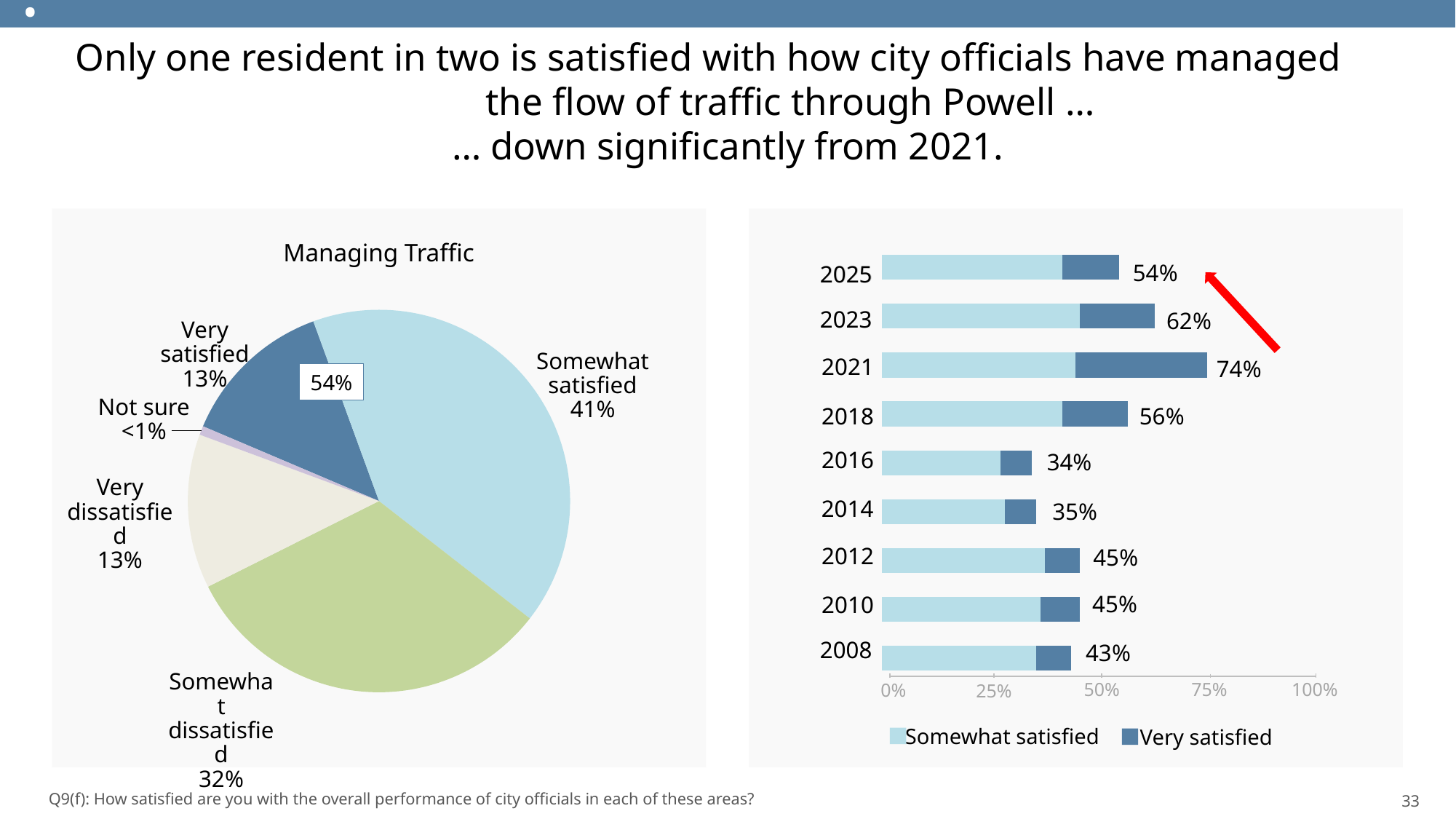
In the bar chart on the right, what is the total satisfied percentage for 2021? 74% In the bar chart on the right, which year has the lowest total satisfied percentage? 2016 In the Managing Traffic pie chart, which slice is the smallest? Not sure In the bar chart on the right, is the total satisfied percentage higher in 2023 or in 2018? 2023 In the bar chart on the right, is the Somewhat satisfied value for 2016 greater or less than 50%? less How many years are shown in the bar chart on the right? 9 In the Managing Traffic pie chart, which slice is the largest? Somewhat satisfied In the Managing Traffic pie chart, what is the difference between the somewhat satisfied and somewhat dissatisfied shares? 9 percentage points In the bar chart on the right, which year has the highest total satisfied percentage? 2021 In the bar chart on the right, how much did the total satisfied percentage fall from 2021 to 2025? 20 percentage points In the Managing Traffic pie chart, what share of residents are somewhat satisfied? 41% How many series does the legend of the bar chart on the right list? 2